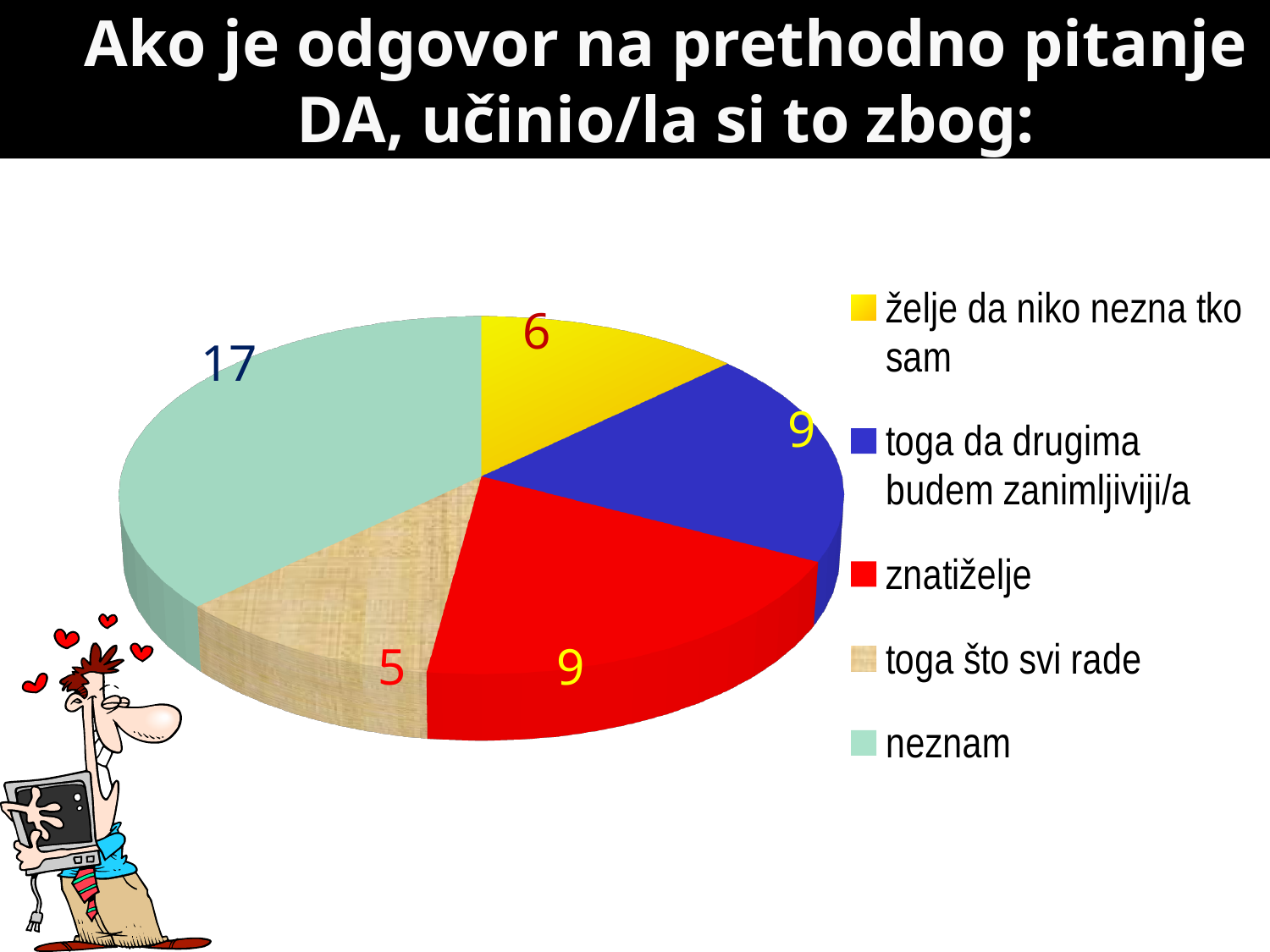
Which is larger, the value for "neznam" or the value for "toga da drugima budem zanimljiviji/a"? neznam How many slices does the pie chart have? 5 What is the difference between the values for "neznam" and "toga što svi rade"? 12 What is the value for "znatiželje"? 9 What is the value for "neznam"? 17 What is the difference between the values for "znatiželje" and "želje da niko nezna tko sam"? 3 What is the value for "želje da niko nezna tko sam"? 6 What is the value for "toga što svi rade"? 5 What kind of chart is shown on the slide? pie chart Which colour represents "znatiželje" in the legend? red Which category has the largest slice? neznam Which category has the smallest slice? toga što svi rade